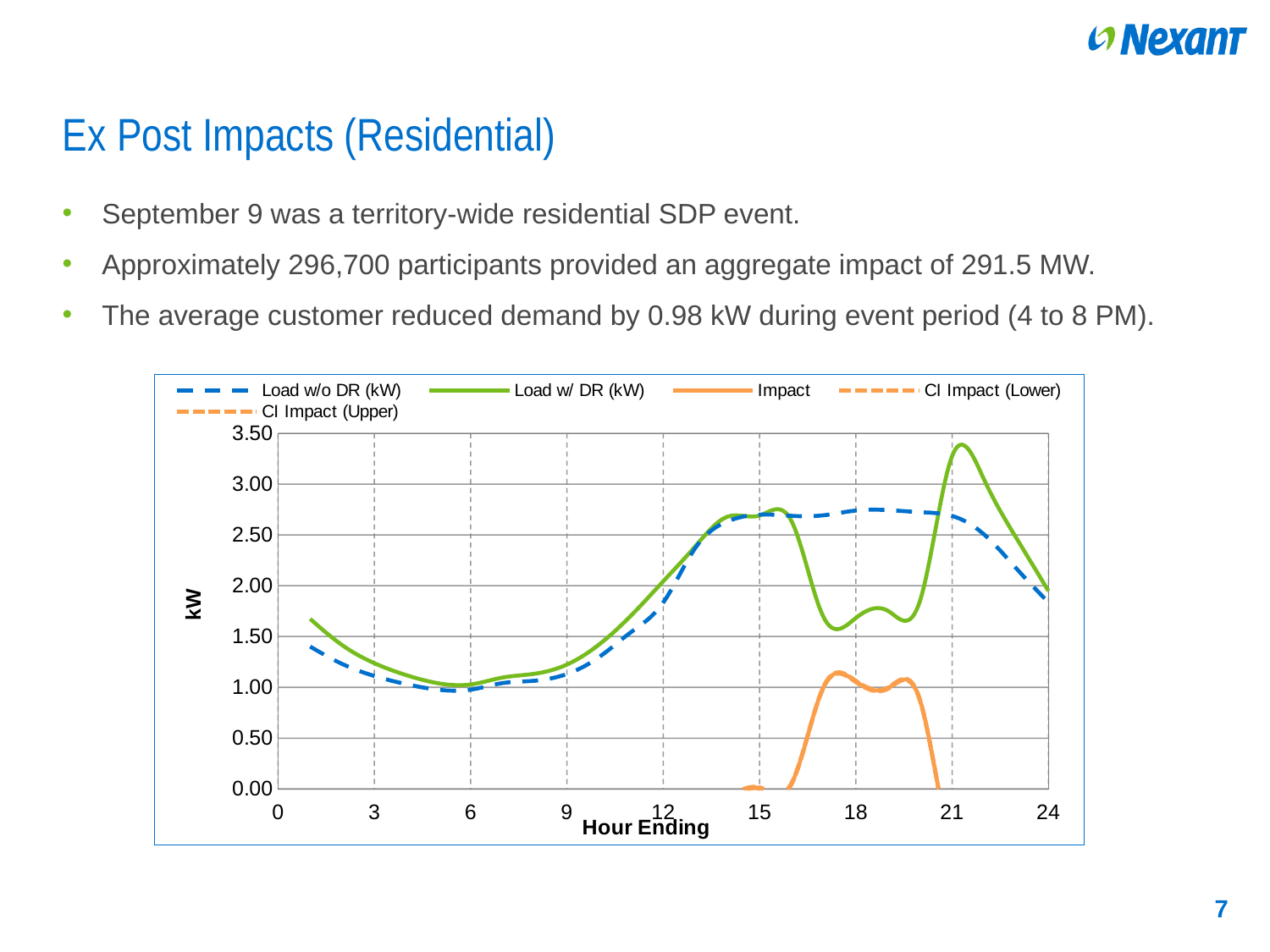
Which series reaches the highest value on the chart? Load w/ DR (kW) Is the value of Load w/o DR (kW) at hour ending 18 greater or less than 2.50? greater What kind of chart is shown on the slide? line chart What is the title of the x axis of the chart? Hour Ending At hour ending 18, which is higher: Load w/o DR (kW) or Load w/ DR (kW)? Load w/o DR (kW) Is the value of Load w/o DR (kW) at hour ending 6 greater or less than 1.50? less What is the title of the y axis of the chart? kW How many series does the chart legend list? 5 Does Load w/ DR (kW) rise or fall between hour ending 6 and hour ending 14? rise Is the value of Impact at hour ending 18 greater or less than 0.50? greater